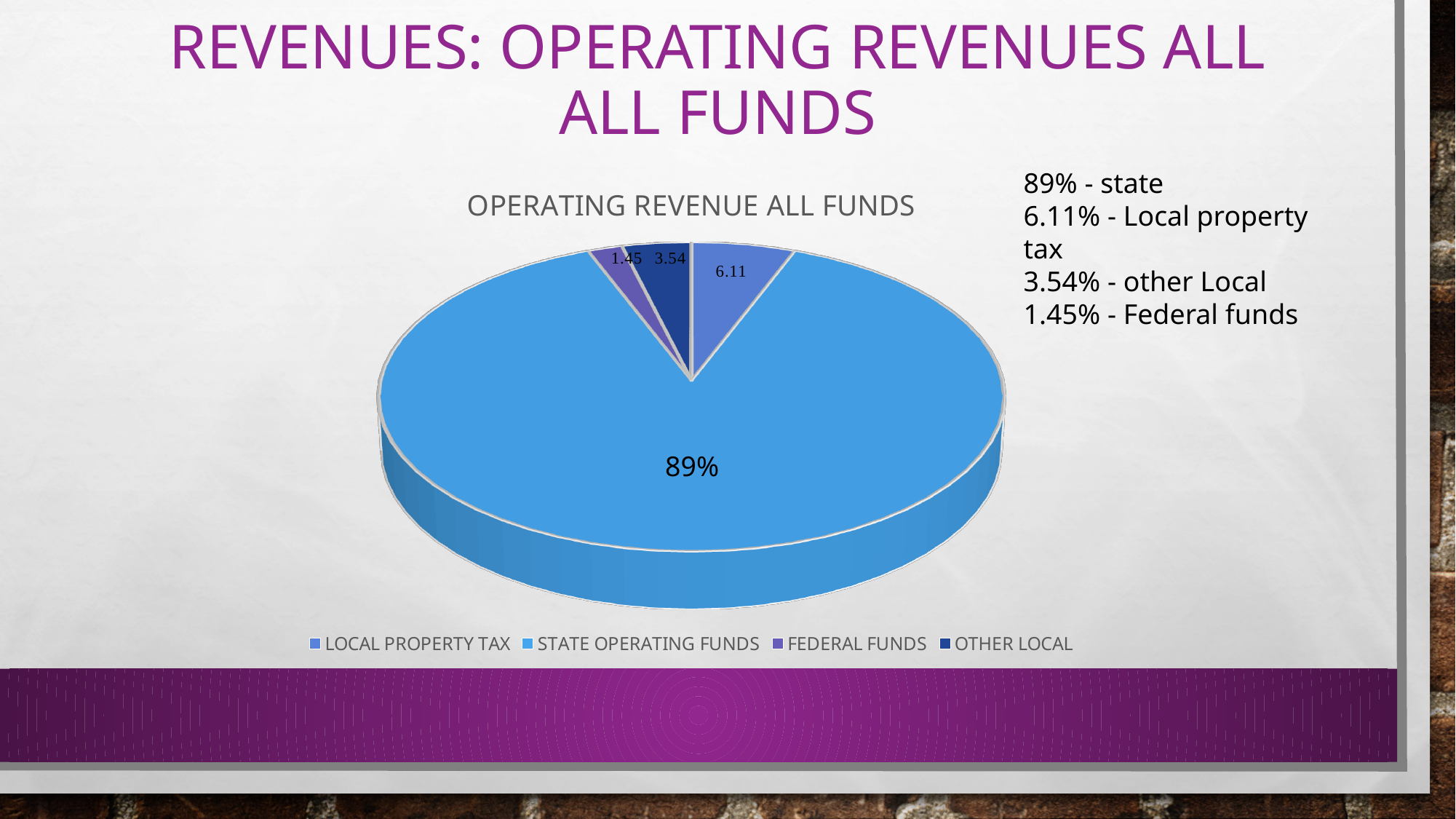
What is the title of the chart? OPERATING REVENUE ALL FUNDS What value is labelled on the State Operating Funds slice? 89% Which category has the largest share of the pie? State Operating Funds Which is larger, the Local Property Tax slice or the Other Local slice? Local Property Tax How many slices does the pie chart have? 4 How many entries does the chart legend list? 4 What value is labelled on the Other Local slice? 3.54 Which category has the smallest share of the pie? Federal Funds What type of chart is shown on the slide? Pie chart What value is labelled on the Local Property Tax slice? 6.11 What is the difference between the Local Property Tax value and the Other Local value? 2.57 What value is labelled on the Federal Funds slice? 1.45